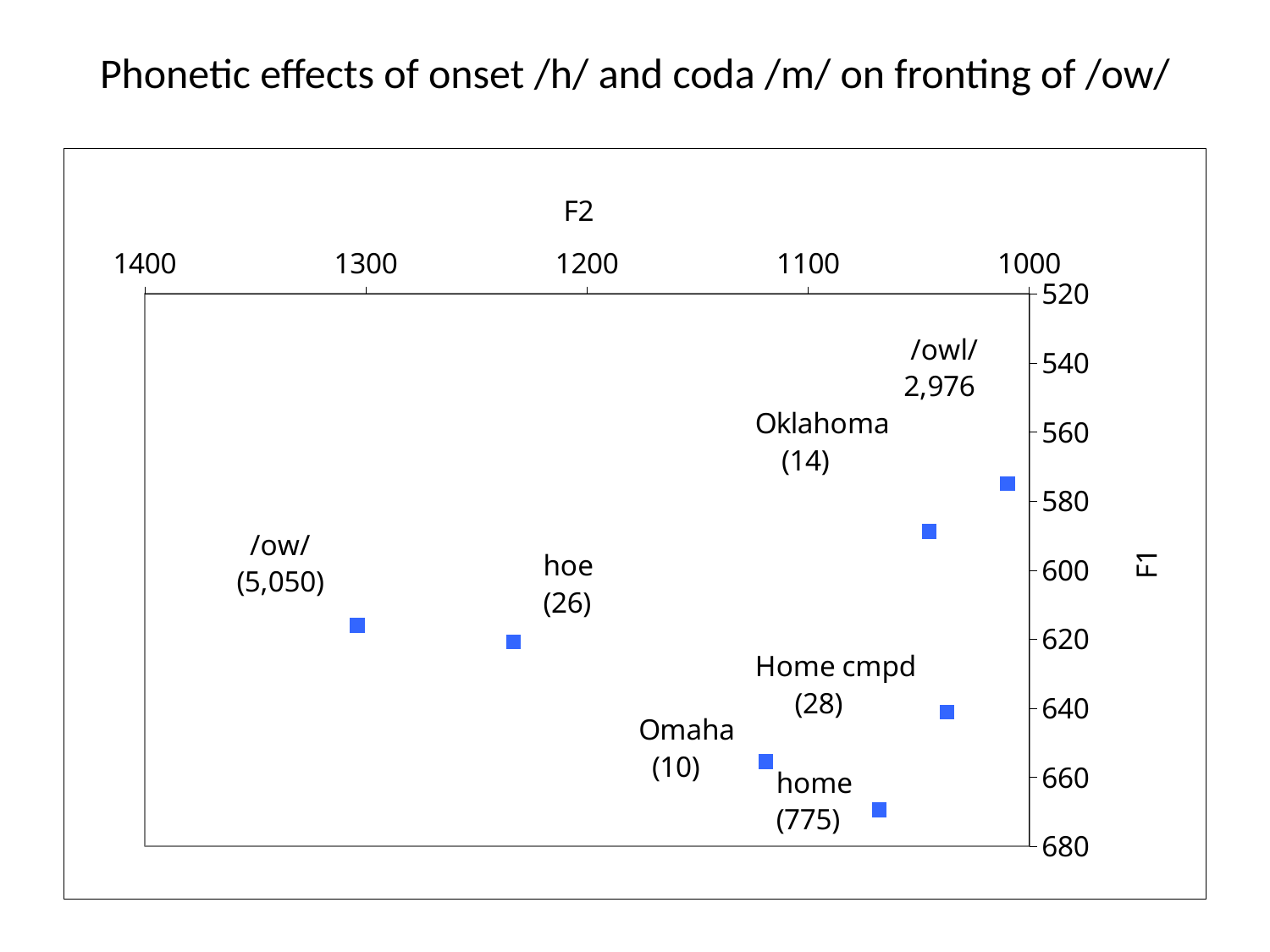
Is the F2 value for hoe (26) greater or less than 1200? greater Which has the larger F2 value, /ow/ (5,050) or hoe (26)? /ow/ (5,050) Is the F1 value for Oklahoma (14) greater or less than 600? less What is the title of the vertical axis? F1 What is the title of the horizontal axis? F2 How many data points are plotted on the chart? 7 Which labelled point has the lowest F2 value? /owl/ 2,976 Is the F1 value for Omaha (10) greater or less than 640? greater What kind of chart is shown on the slide? scatter chart Which labelled point has the highest F2 value? /ow/ (5,050) Which labelled point has the highest F1 value? home (775) Which labelled point has the lowest F1 value? /owl/ 2,976